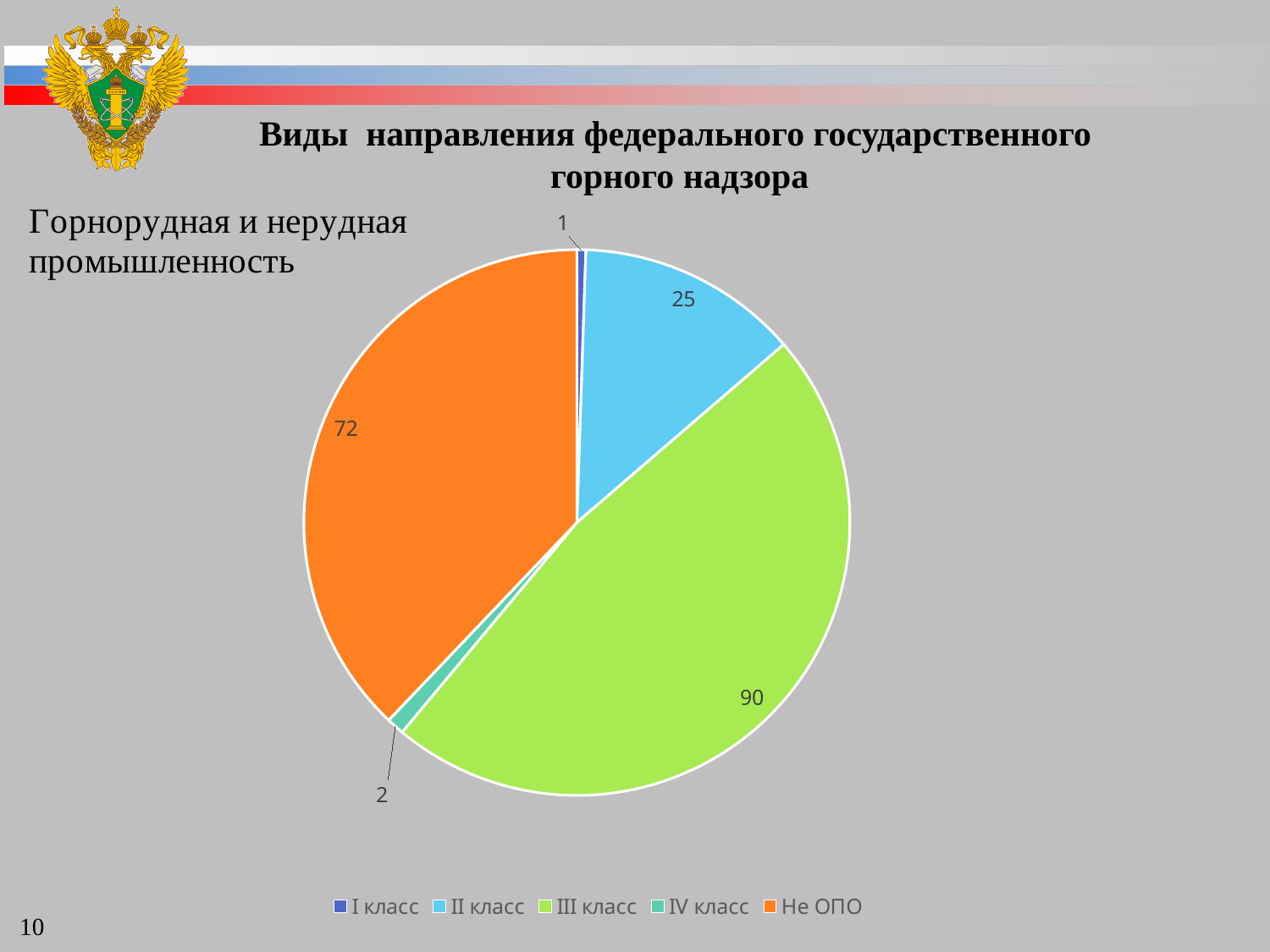
What is the value for II класс? 25 Which is larger, the value for II класс or the value for Не ОПО? Не ОПО What is the difference between the values for III класс and Не ОПО? 18 What kind of chart is shown on the slide? pie chart What is the value for III класс? 90 Which category has the smallest slice of the pie? I класс Which category has the largest slice of the pie? III класс What is the total of all the values shown on the pie chart? 190 What is the value for I класс? 1 What is the value for IV класс? 2 What is the value for Не ОПО? 72 How many categories does the legend list? 5